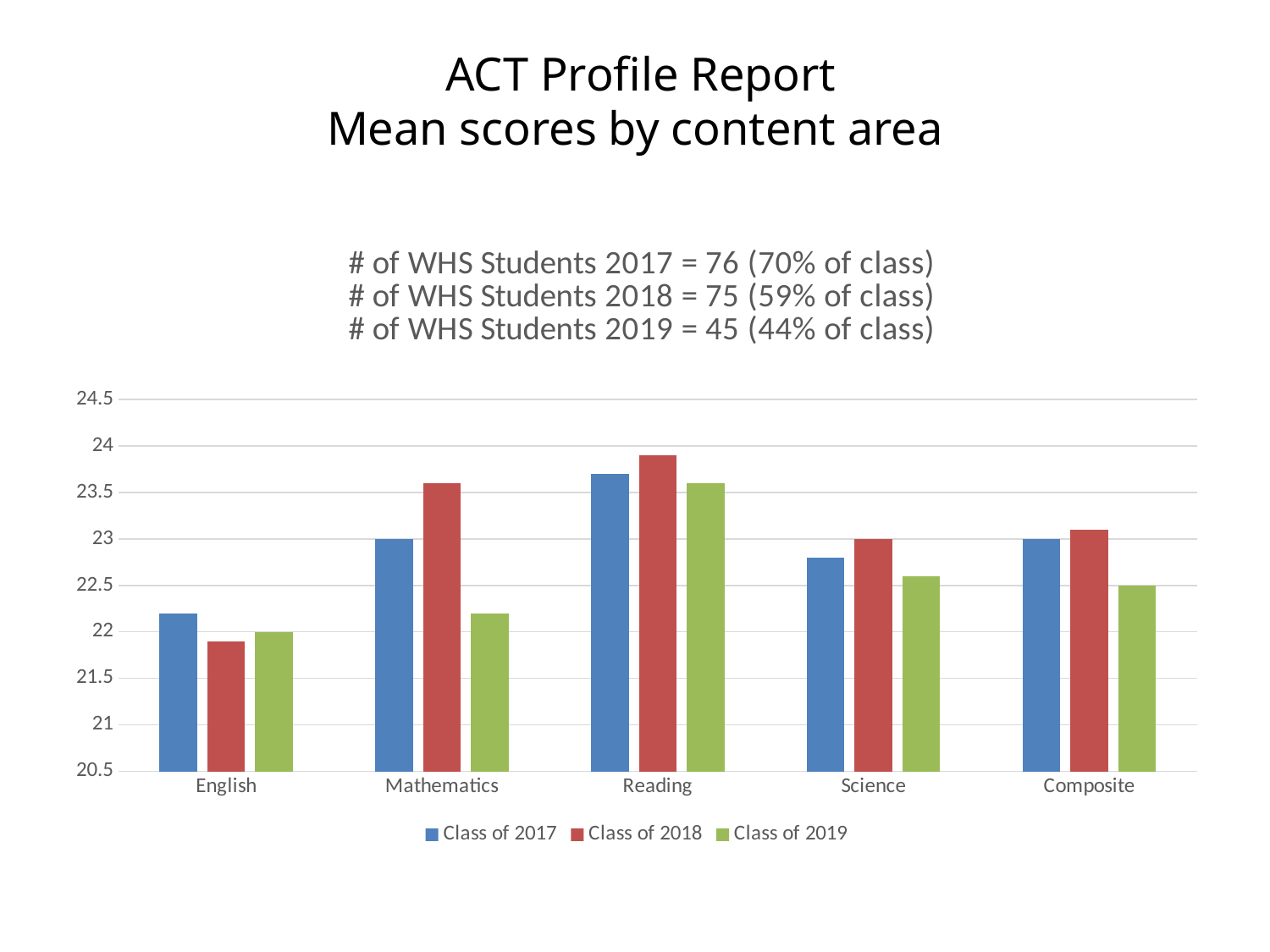
Which content area has the lowest bar for the Class of 2017? English What is the mean Composite score for the Class of 2019? 22.5 Is the Reading score for the Class of 2018 greater or less than 23.5? greater How many content areas are shown on the x axis of the chart? 5 What kind of chart is shown on the slide? Bar chart Is the English score for the Class of 2018 greater or less than 22? less Which series is shown in red in the chart? Class of 2018 Which content area has the highest bar for the Class of 2018? Reading What is the mean English score for the Class of 2019? 22 For Mathematics, which is larger: the Class of 2018 score or the Class of 2019 score? Class of 2018 How many series does the chart's legend list? 3 What is the mean Mathematics score for the Class of 2017? 23